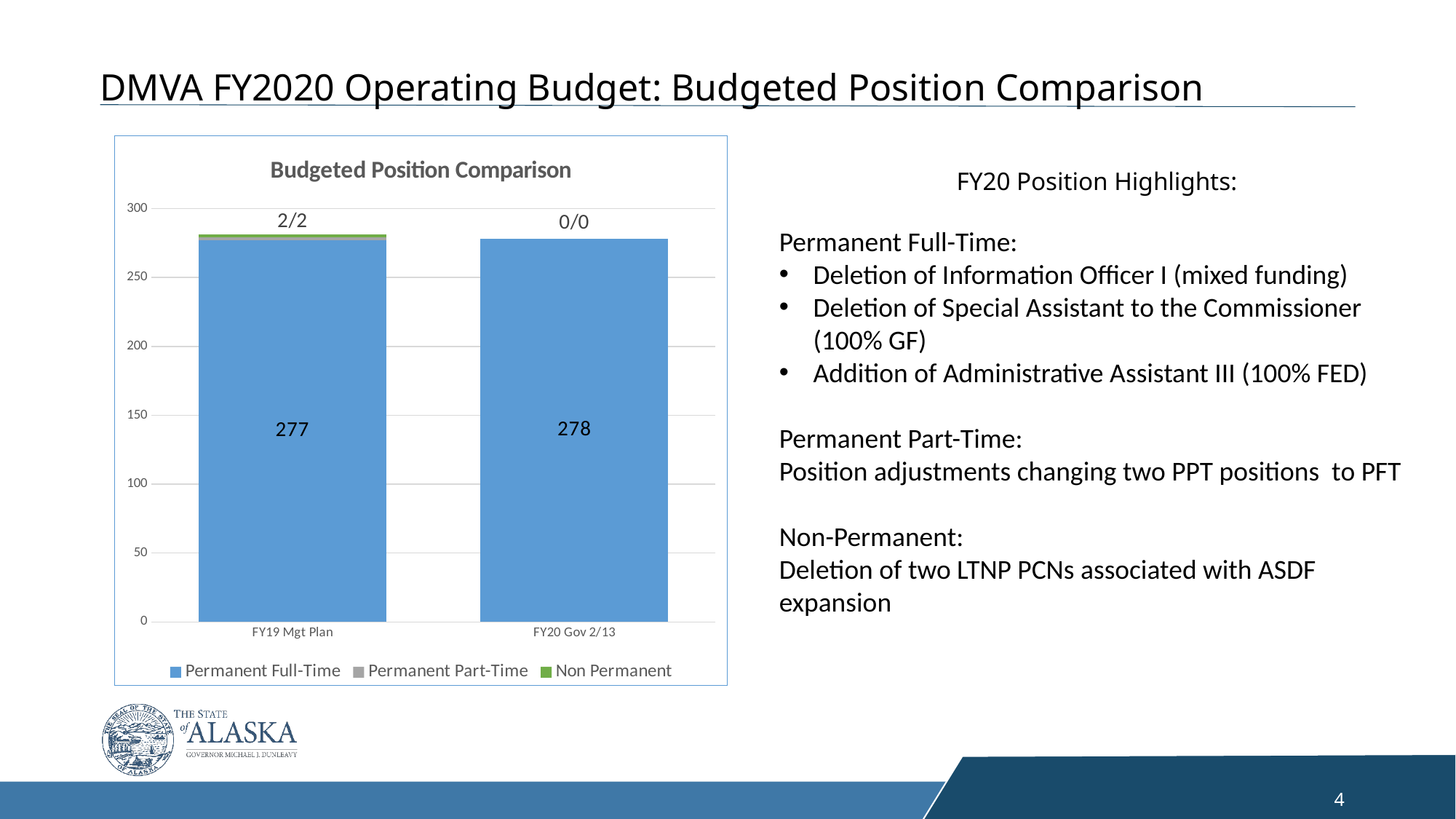
What label is printed above the FY19 Mgt Plan bar? 2/2 Is the Permanent Full-Time value for FY19 Mgt Plan greater or less than 250? greater What is the title of the chart? Budgeted Position Comparison How many categories are shown on the x axis of the chart? 2 How many series does the chart legend list? 3 What is the difference between the Permanent Full-Time values for FY20 Gov 2/13 and FY19 Mgt Plan? 1 What is the Permanent Full-Time value for FY19 Mgt Plan? 277 What label is printed above the FY20 Gov 2/13 bar? 0/0 What is the Permanent Full-Time value for FY20 Gov 2/13? 278 Which category has the higher Permanent Full-Time value, FY19 Mgt Plan or FY20 Gov 2/13? FY20 Gov 2/13 Does the Permanent Full-Time value rise or fall from FY19 Mgt Plan to FY20 Gov 2/13? rise What kind of chart is shown on the slide? Stacked bar chart